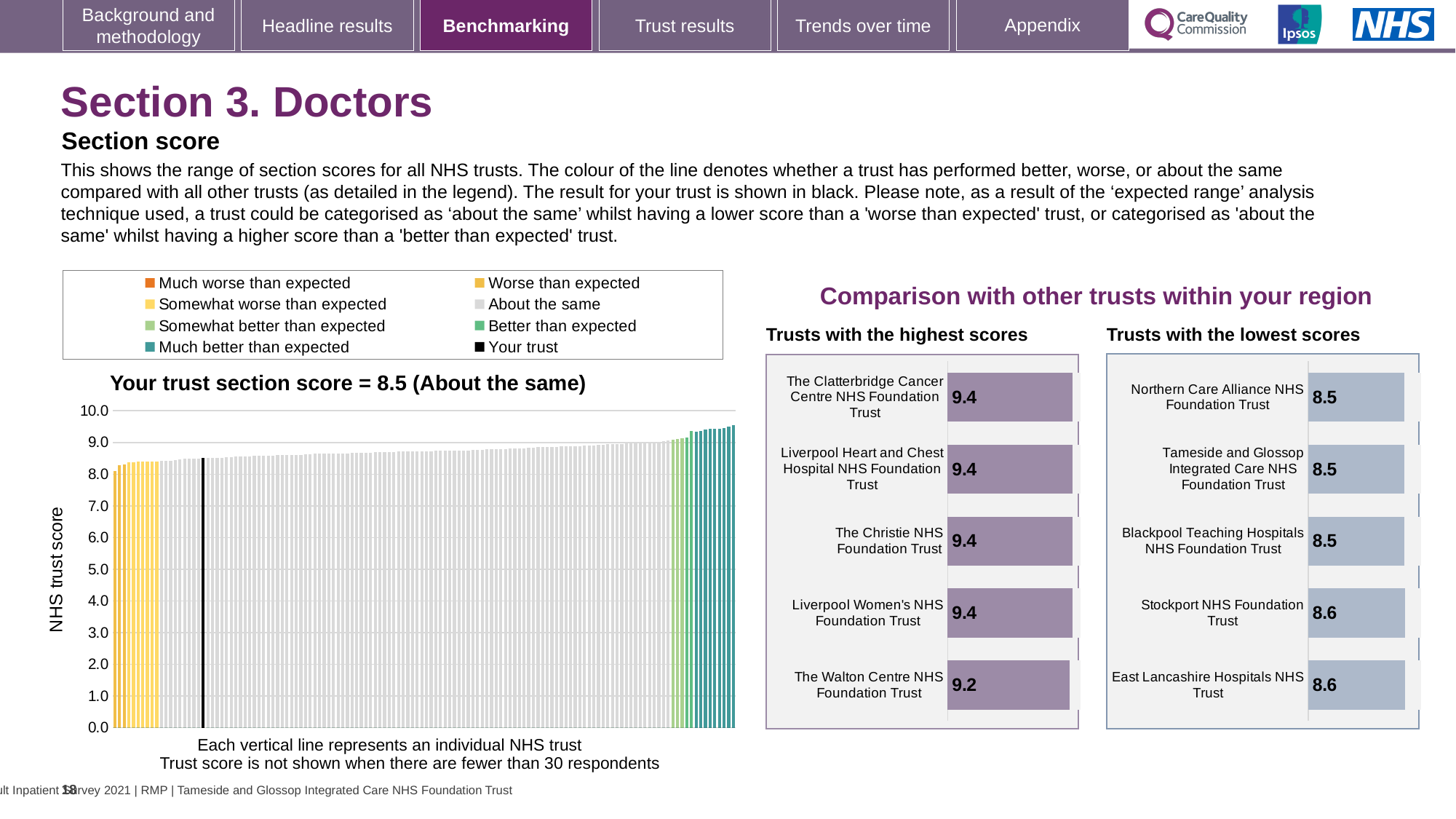
In the 'Trusts with the highest scores' chart, what is the difference between the score for The Clatterbridge Cancer Centre NHS Foundation Trust and The Walton Centre NHS Foundation Trust? 0.2 In the 'Trusts with the lowest scores' chart, what is the score for Blackpool Teaching Hospitals NHS Foundation Trust? 8.5 Which is larger: the score for The Walton Centre NHS Foundation Trust in the 'Trusts with the highest scores' chart, or the score for Stockport NHS Foundation Trust in the 'Trusts with the lowest scores' chart? The Walton Centre NHS Foundation Trust How many entries does the legend above the main section score chart list? 8 In the 'Trusts with the highest scores' chart, what is the score for The Christie NHS Foundation Trust? 9.4 In the 'Trusts with the highest scores' chart, which trust has the lowest score? The Walton Centre NHS Foundation Trust In the main section score chart on the left, do the trust scores rise or fall from left to right along the x axis? rise How many trusts are shown in the 'Trusts with the lowest scores' chart? 5 In the 'Trusts with the highest scores' chart, what is the score for The Walton Centre NHS Foundation Trust? 9.2 In the main section score chart on the left, what is the section score for your trust? 8.5 In the 'Trusts with the lowest scores' chart, what is the difference between the score for East Lancashire Hospitals NHS Trust and Northern Care Alliance NHS Foundation Trust? 0.1 In the 'Trusts with the lowest scores' chart, what is the score for Stockport NHS Foundation Trust? 8.6